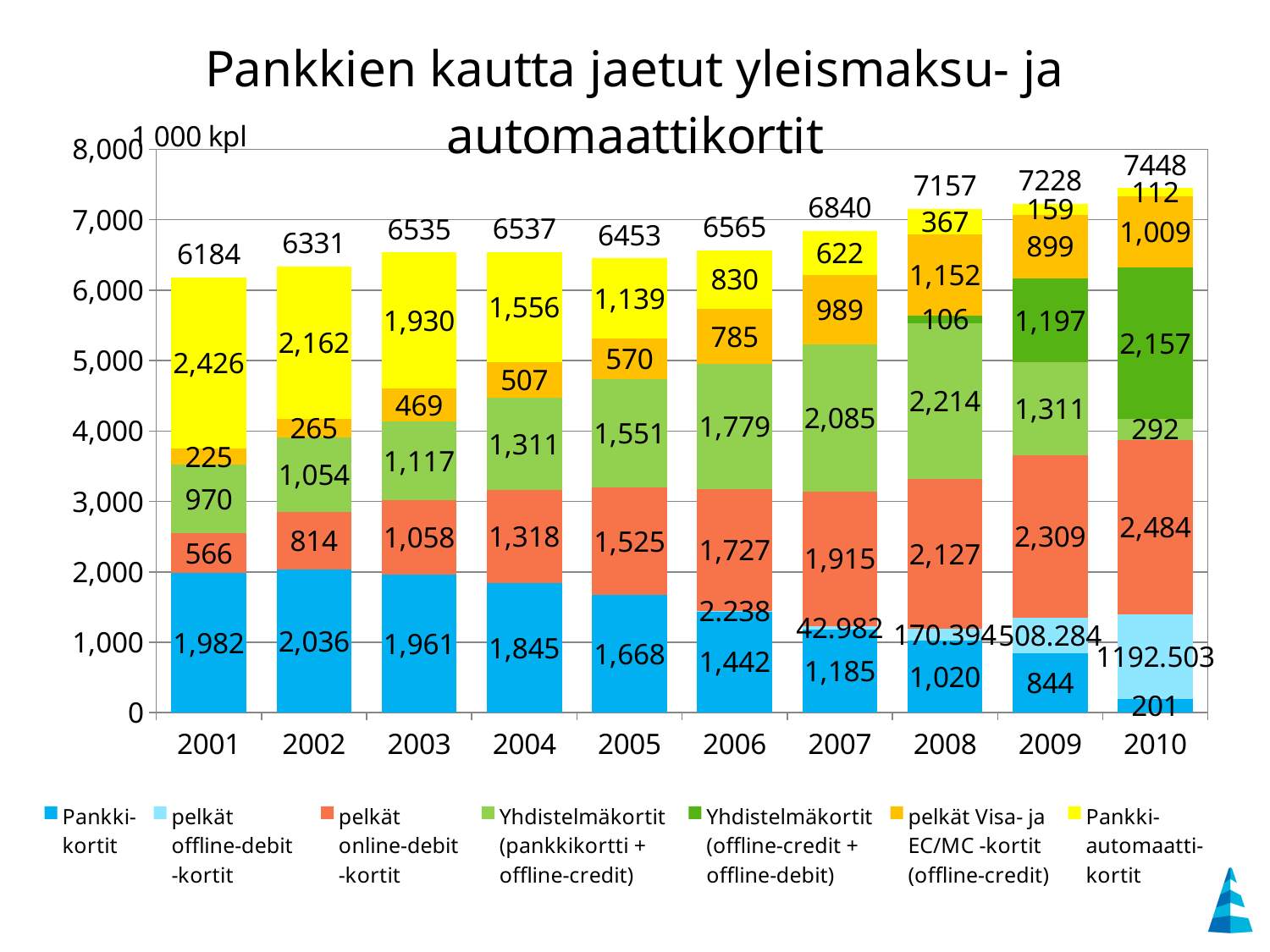
What is the value for Pankkiautomaattikortit in 2003? 1,930 How many series does the legend list? 7 Which year has the highest total shown above its bar? 2010 What kind of chart is shown on the slide? stacked bar chart What is the total number of cards shown above the bar for 2010? 7448 In 2009, which is larger: pelkät online-debit -kortit or Pankkikortit? pelkät online-debit -kortit What is the value for Pankkikortit in 2001? 1,982 What is the difference between the Pankkikortit value in 2001 and in 2010? 1,781 Does the Pankkiautomaattikortit value rise or fall from 2001 to 2010? fall Which year has the lowest total shown above its bar? 2001 How many years are shown on the x axis? 10 What is the value for Yhdistelmäkortit (offline-credit + offline-debit) in 2010? 2,157